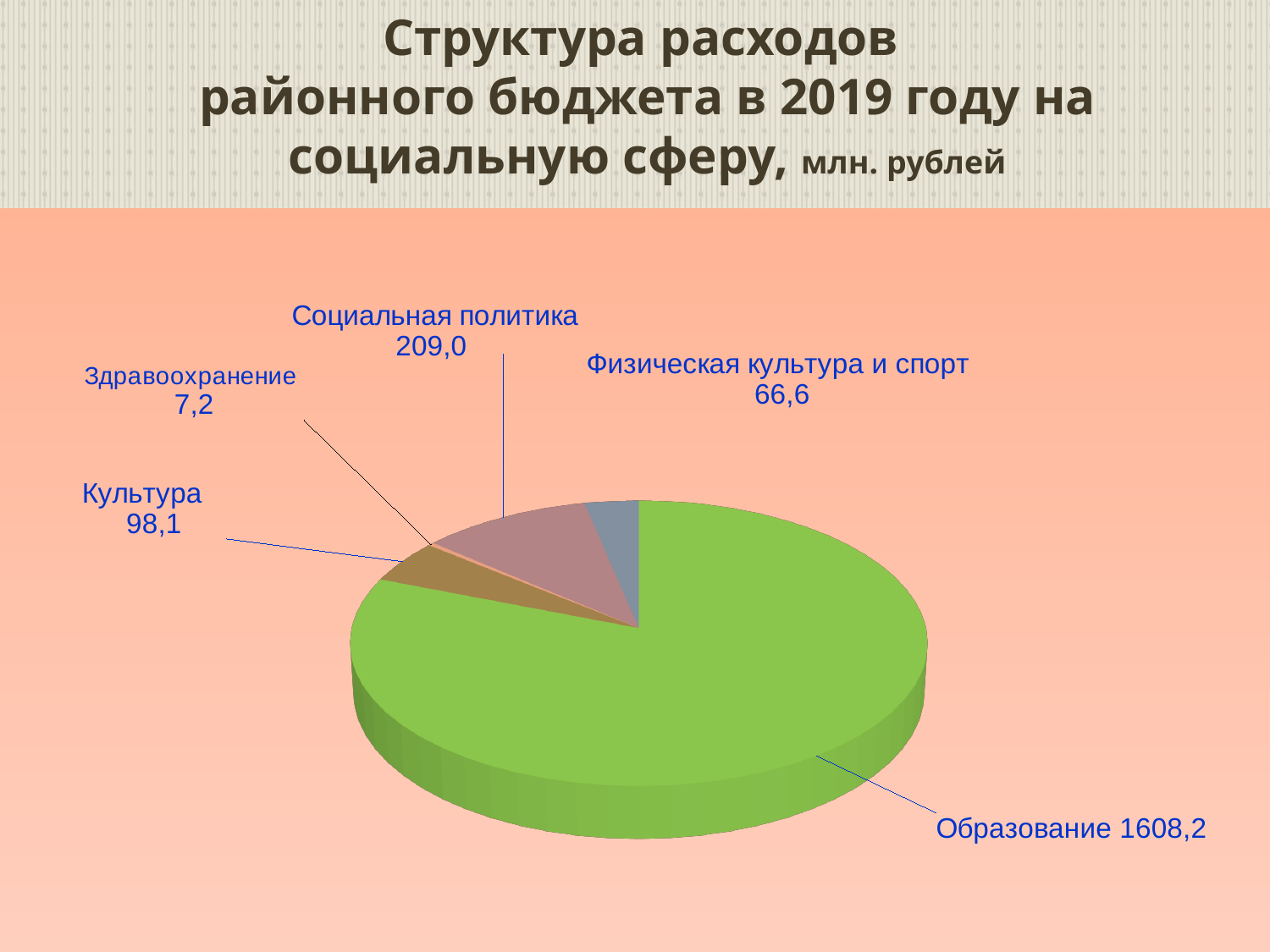
What is the value for Культура? 98,1 What is the value for Социальная политика? 209,0 Which category has the largest share of the pie? Образование How many slices (categories) does the pie chart have? 5 What is the value for Образование? 1608,2 What is the difference between the values for Социальная политика and Культура? 110,9 Which is larger, Культура or Физическая культура и спорт? Культура What unit is stated in the chart title for the values? млн. рублей What is the value for Физическая культура и спорт? 66,6 Which category has the smallest share of the pie? Здравоохранение What is the value for Здравоохранение? 7,2 What type of chart is shown on the slide? Pie chart